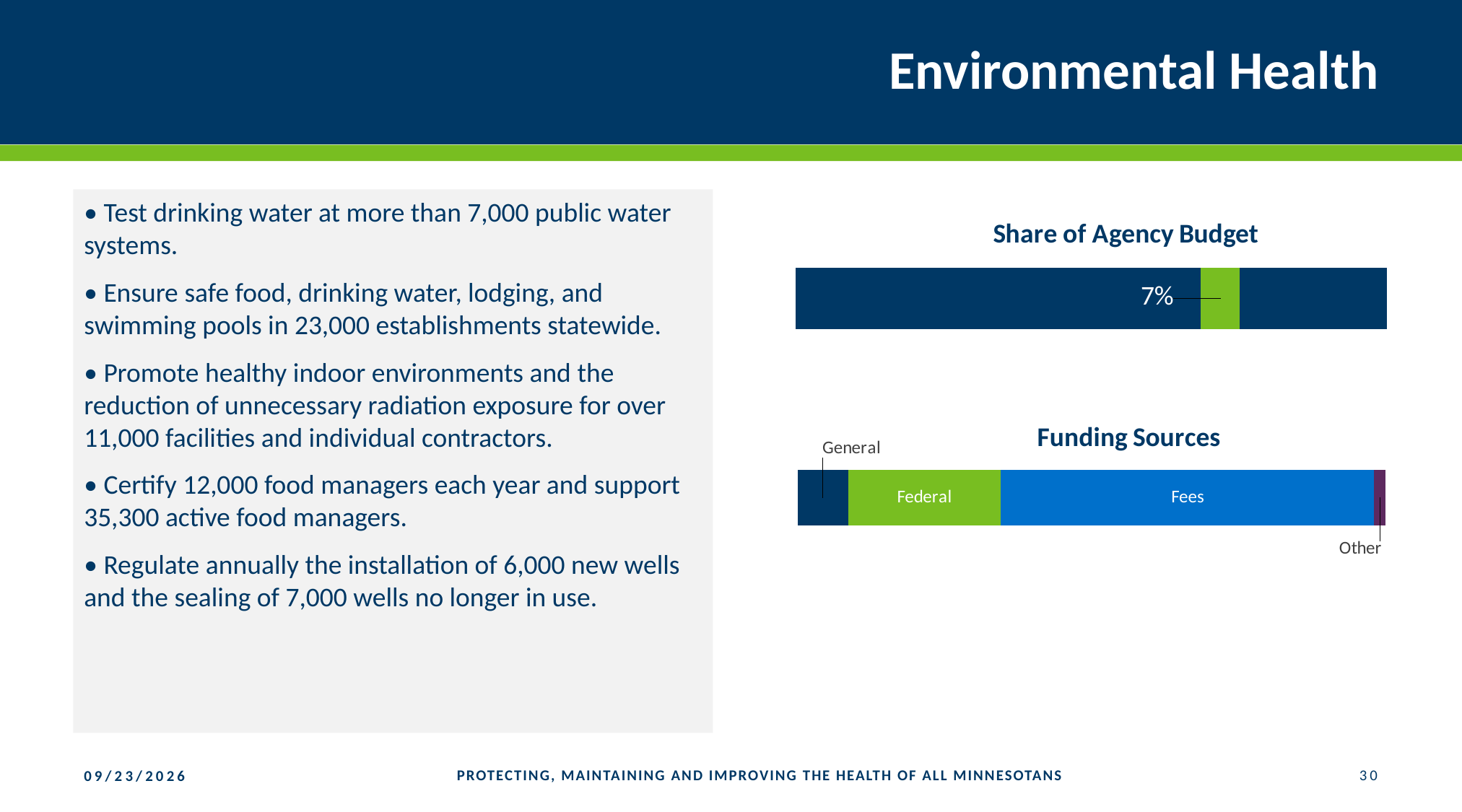
In the Share of Agency Budget chart, what percentage of the agency budget is labelled for Environmental Health? 7% In the Funding Sources chart, how many funding source segments are shown? 4 In the Funding Sources chart, what colour is the Fees segment? blue What kind of chart is the Share of Agency Budget chart? bar chart In the Funding Sources chart, which is larger, Federal or Fees? Fees What is the title of the lower chart on the slide? Funding Sources In the Funding Sources chart, which funding source is the smallest? Other In the Funding Sources chart, which is larger, General or Other? General In the Funding Sources chart, which is larger, General or Federal? Federal What kind of chart is the Funding Sources chart? bar chart In the Funding Sources chart, which funding source is the largest? Fees